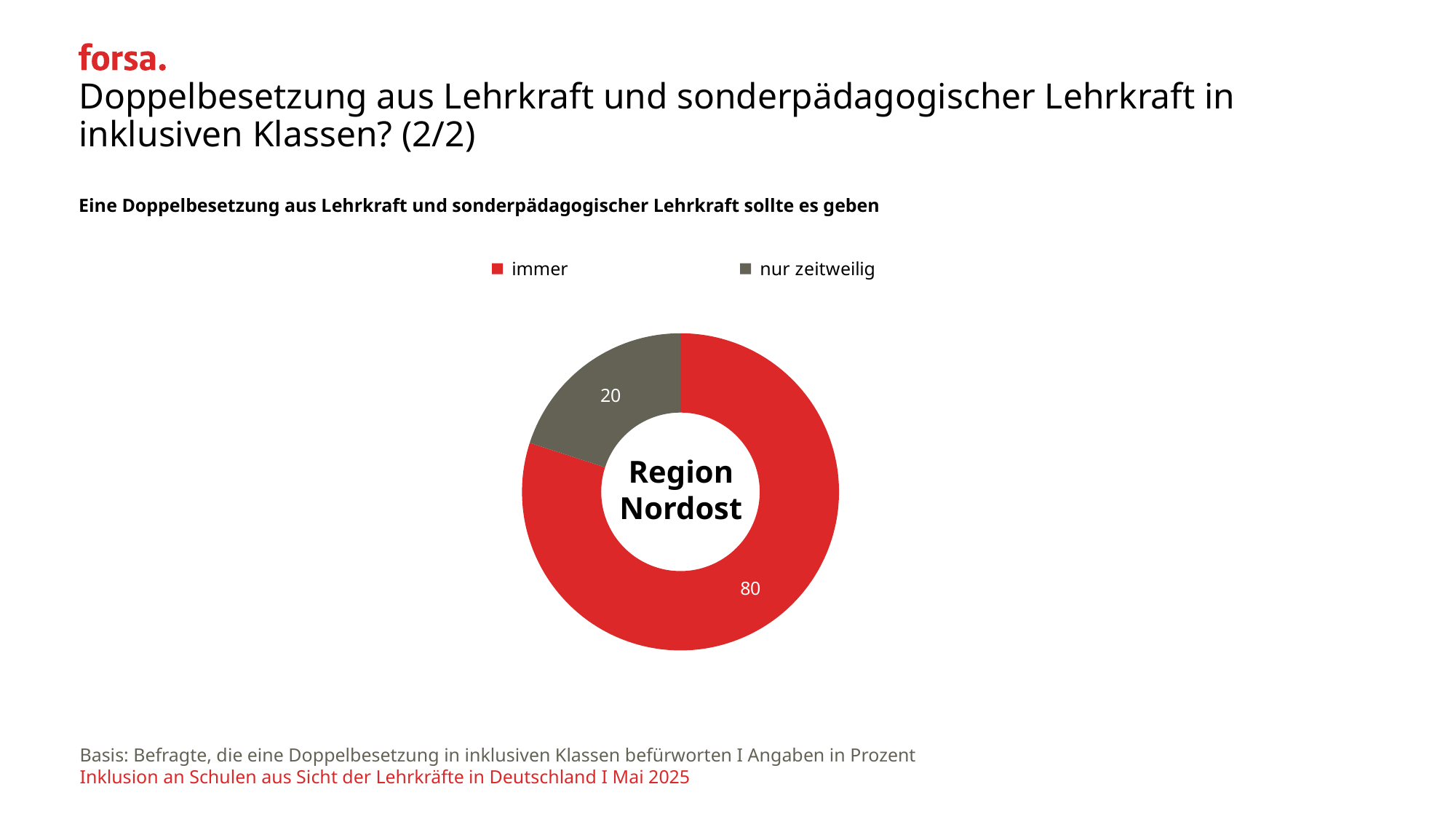
What is the difference between the values for "immer" and "nur zeitweilig"? 60 What label is printed in the centre of the donut chart? Region Nordost What kind of chart is shown on the slide? Pie chart (donut) Which category has the largest share in the chart? immer What is the value for "nur zeitweilig" in the Region Nordost chart? 20 What is the total of the two values shown in the chart? 100 Which colour represents "nur zeitweilig" in the chart? Grey Which is larger, the value for "immer" or the value for "nur zeitweilig"? immer Which category has the smallest share in the chart? nur zeitweilig What is the value for "immer" in the Region Nordost chart? 80 How many categories does the chart show? 2 How many entries does the legend list? 2